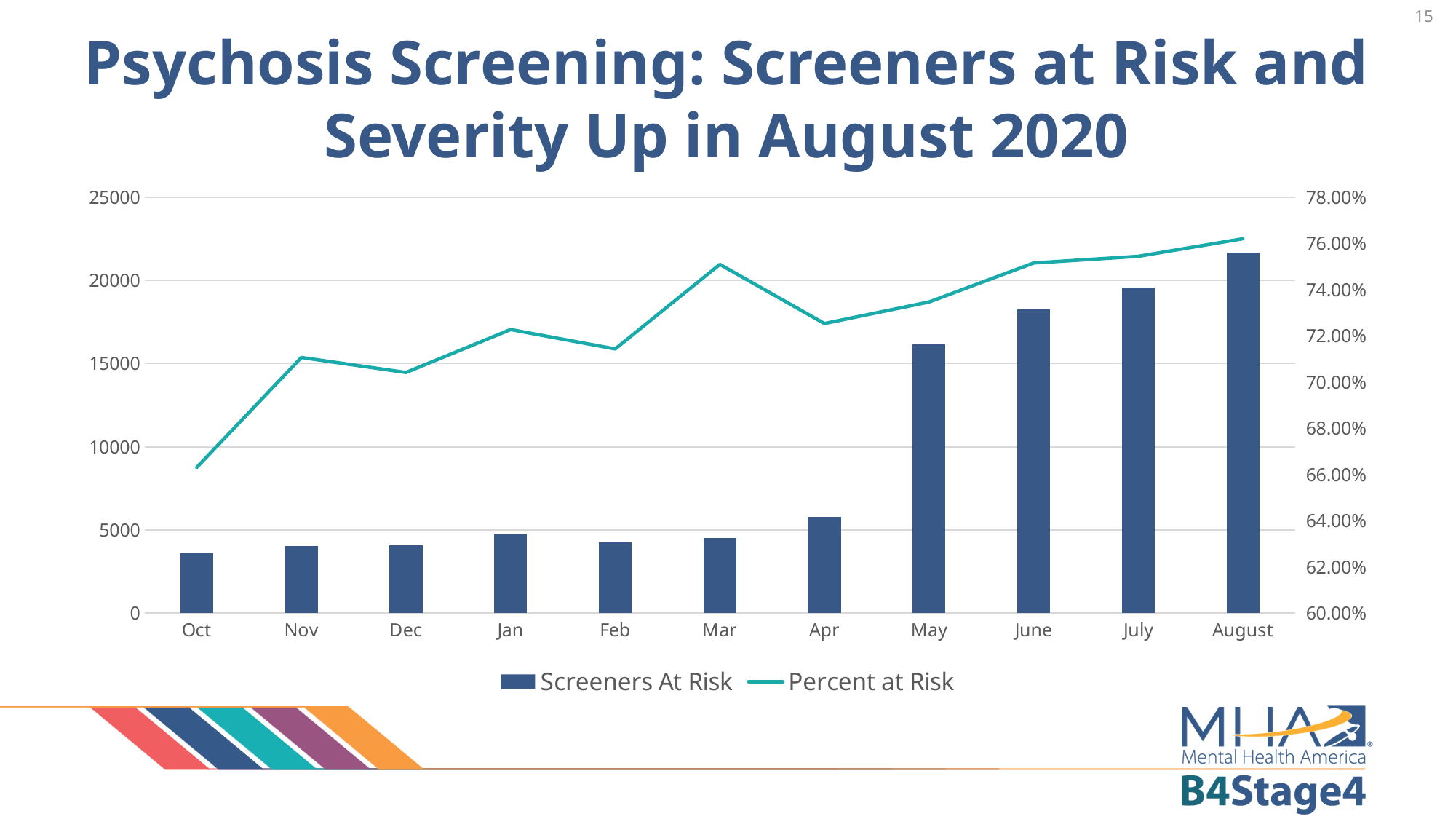
Is the Screeners At Risk value for August greater or less than 20000? greater Is the Percent at Risk for Oct greater or less than 68.00%? less Do the Screeners At Risk values rise or fall from May to August? rise What kind of chart is shown on the slide? A combined bar and line chart How many months are shown on the x axis? 11 Which month has more Screeners At Risk, Apr or May? May What are the two series named in the legend? Screeners At Risk and Percent at Risk Which month has the lowest Percent at Risk? Oct Which month has the highest number of Screeners At Risk? August Is the Screeners At Risk value for Apr greater or less than 10000? less Which month has the lowest number of Screeners At Risk? Oct How many series does the legend list? 2